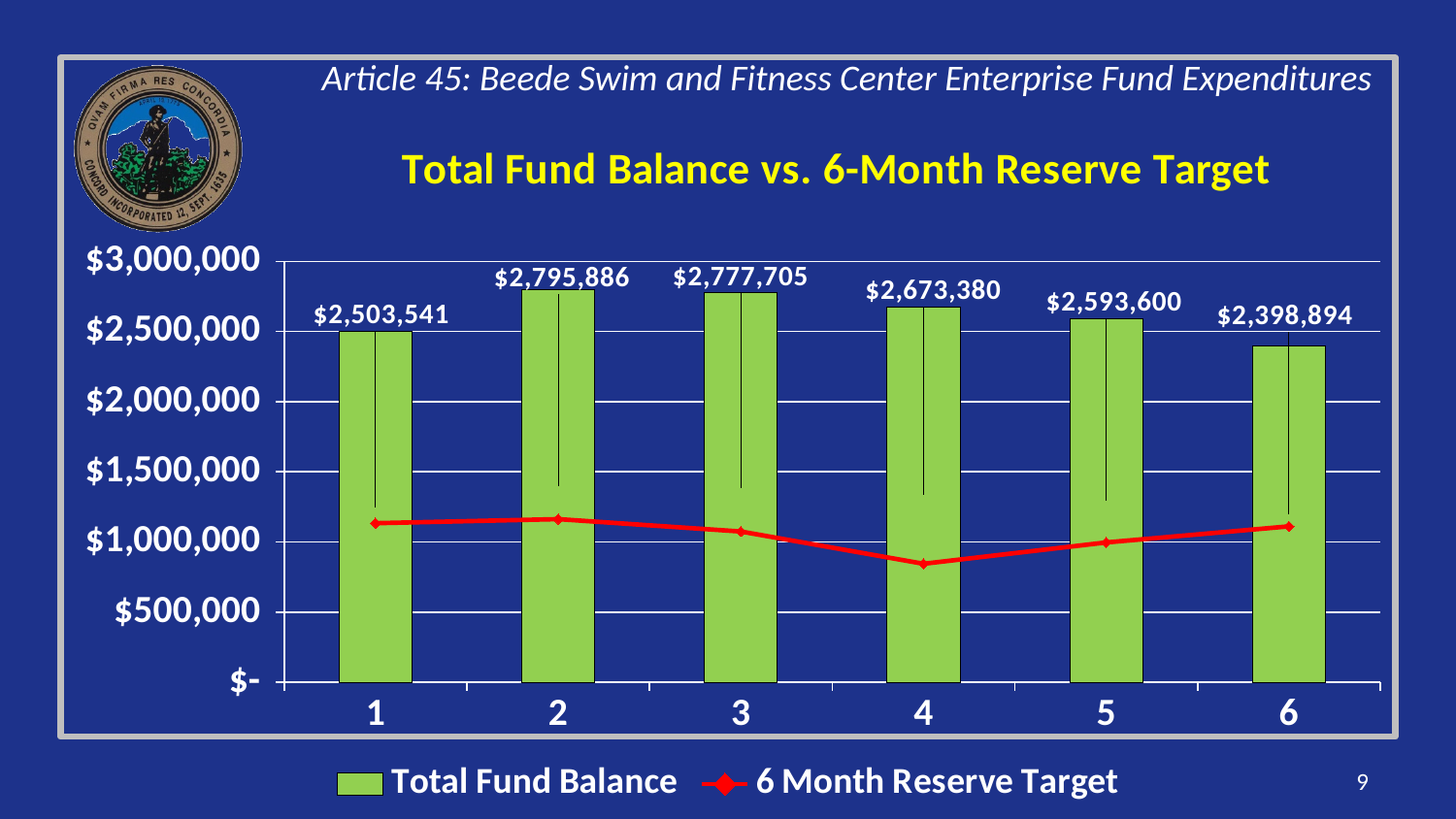
Which category has the lowest Total Fund Balance? 6 What is the difference between the Total Fund Balance for category 4 and category 6? $274,486 How many categories are shown on the x axis? 6 Which category has the highest Total Fund Balance? 2 What is the Total Fund Balance for category 4? $2,673,380 What is the difference between the Total Fund Balance for category 2 and category 1? $292,345 Is the 6 Month Reserve Target for category 4 greater or less than $1,000,000? less What is the Total Fund Balance for category 1? $2,503,541 Does the Total Fund Balance rise or fall from category 2 to category 6? Fall How many series does the legend list? 2 What is the Total Fund Balance for category 6? $2,398,894 Which is larger, the Total Fund Balance for category 3 or category 5? Category 3